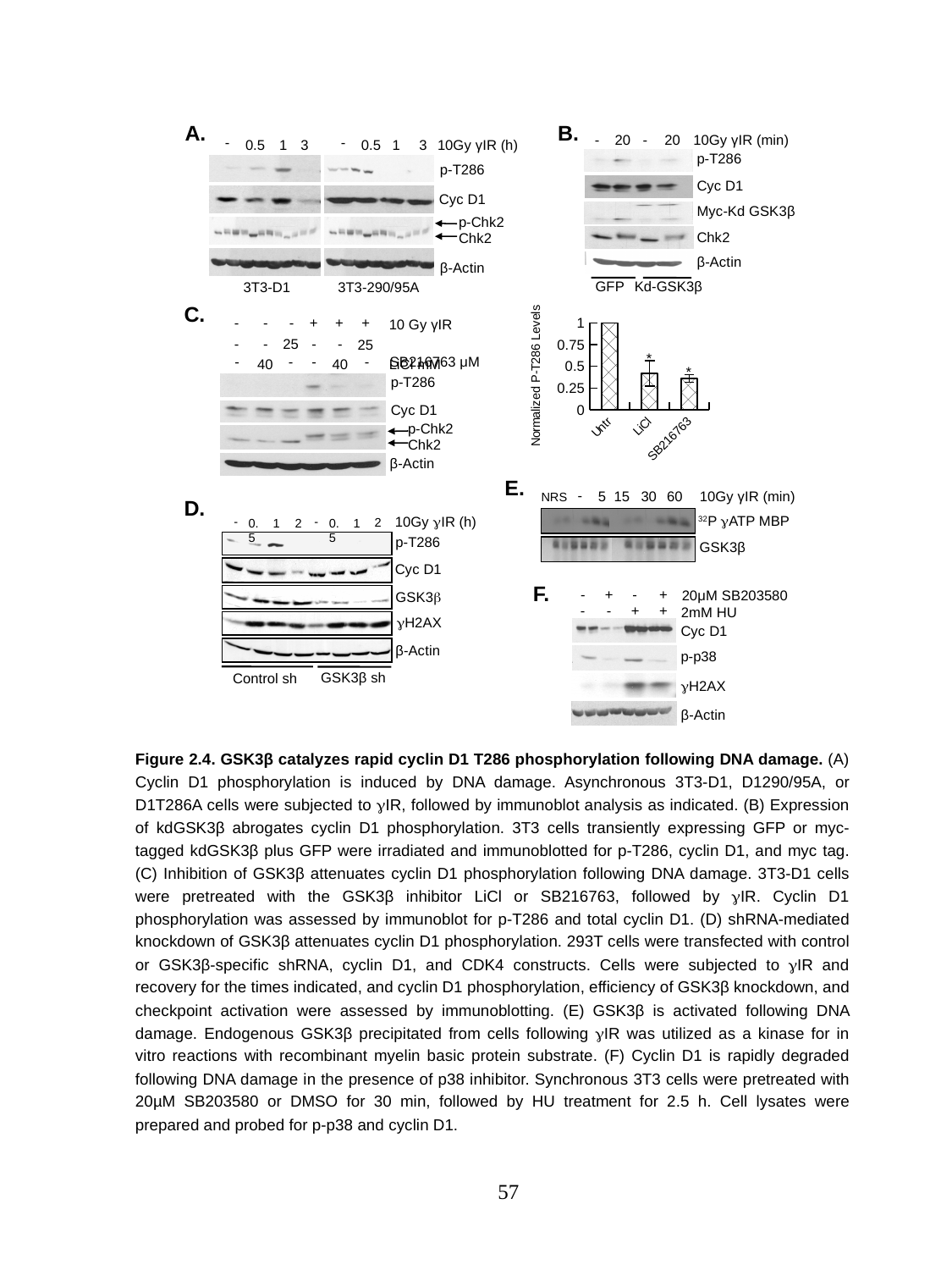
In the Normalized P-T286 Levels chart, which is larger, the value for Untr or the value for LiCl? Untr How many bars does the Normalized P-T286 Levels chart have? 3 In the Normalized P-T286 Levels chart, is the value for LiCl greater or less than 0.25? greater In the Normalized P-T286 Levels chart, what is the value for Untr? 1 In the Normalized P-T286 Levels chart, which category has the highest value? Untr What kind of chart is shown in panel C next to the blots? bar chart What is the y-axis label of the bar chart in panel C? Normalized P-T286 Levels In the Normalized P-T286 Levels chart, do the values rise or fall from left to right across the categories? fall In the Normalized P-T286 Levels chart, is the value for SB216763 greater or less than 0.5? less In the Normalized P-T286 Levels chart, is the value for LiCl greater or less than 0.5? less What is the highest tick value shown on the y-axis of the Normalized P-T286 Levels chart? 1